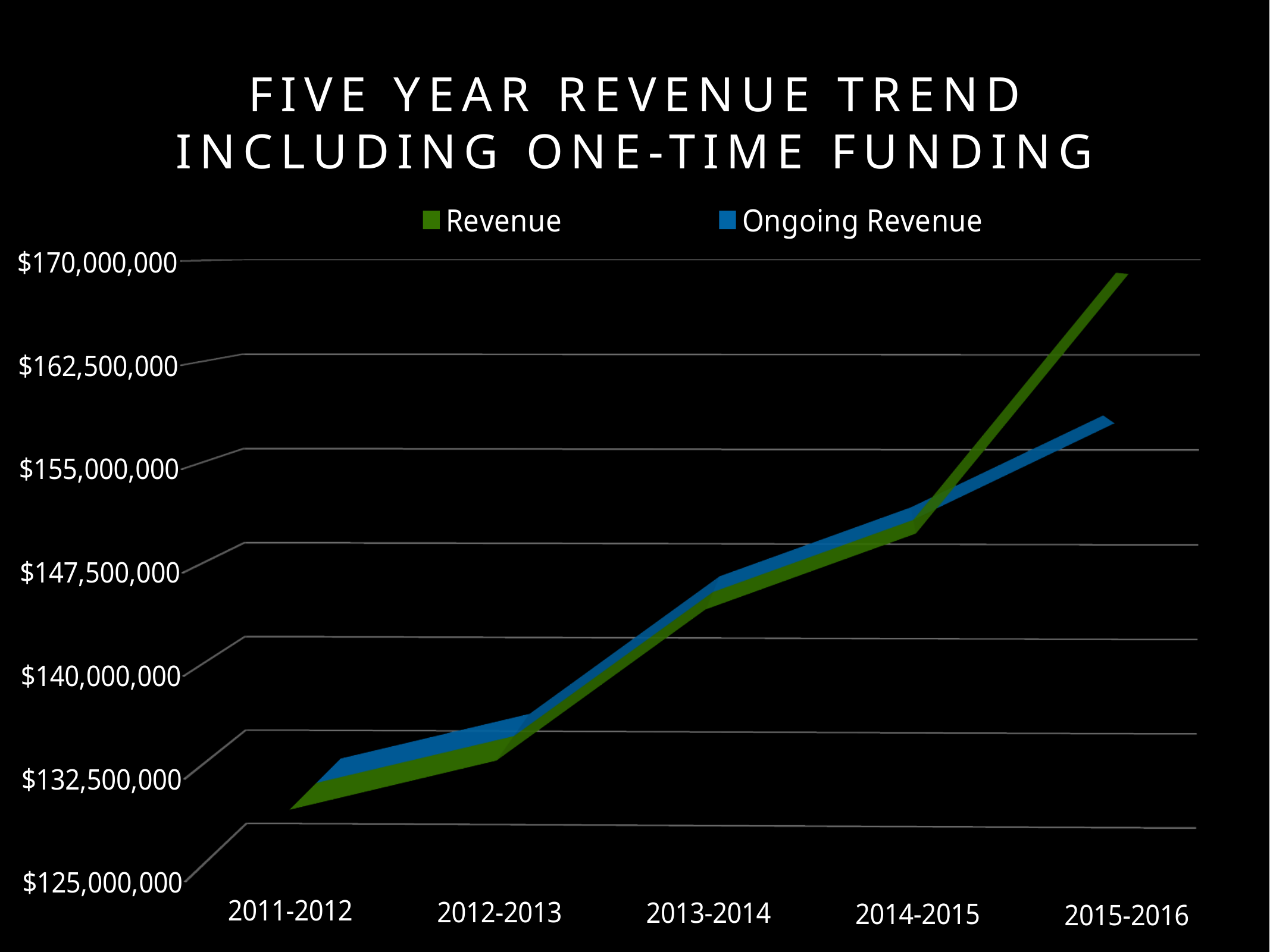
Is the Revenue value for 2011-2012 greater or less than $132,500,000? less Do the Revenue values rise or fall from 2011-2012 to 2015-2016? Rise Which series is shown in green in the legend? Revenue How many fiscal years are plotted along the x axis? 5 How many series does the legend list? 2 In 2015-2016, which is larger: Revenue or Ongoing Revenue? Revenue What kind of chart is shown on the slide? Line chart Is the Ongoing Revenue value for 2014-2015 greater or less than $147,500,000? greater In which year is Ongoing Revenue lowest? 2011-2012 In which year is Revenue highest? 2015-2016 Is the Revenue value for 2015-2016 greater or less than $162,500,000? greater